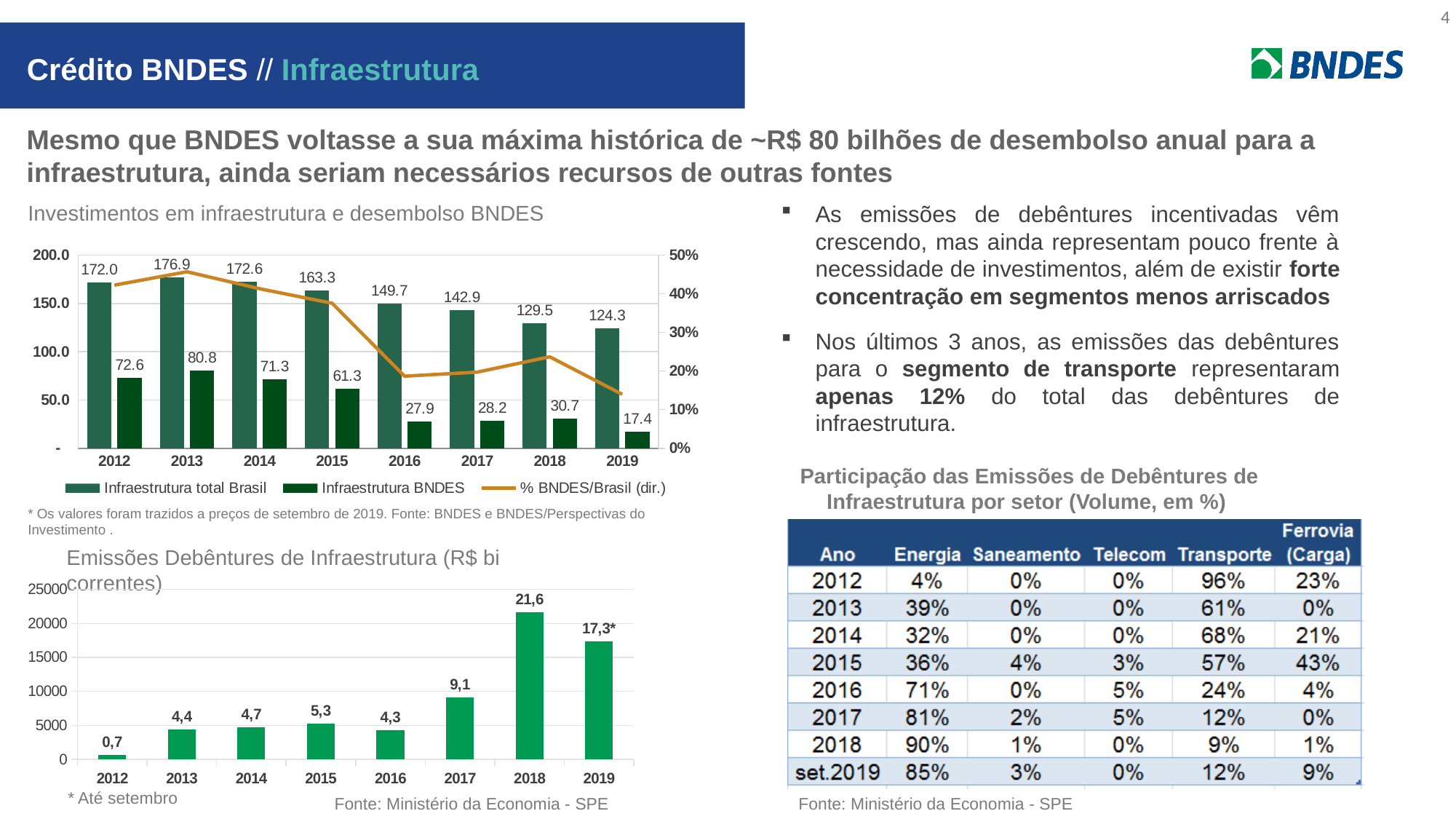
In the chart 'Investimentos em infraestrutura e desembolso BNDES', is the % BNDES/Brasil value for 2013 greater or less than 40%? greater In the chart 'Emissões Debêntures de Infraestrutura (R$ bi correntes)', how many years are shown on the x axis? 8 In the chart 'Emissões Debêntures de Infraestrutura (R$ bi correntes)', what is the value for 2017? 9,1 In the chart 'Emissões Debêntures de Infraestrutura (R$ bi correntes)', which year has the lowest value? 2012 In the chart 'Investimentos em infraestrutura e desembolso BNDES', does Infraestrutura total Brasil rise or fall from 2013 to 2019? fall In the chart 'Investimentos em infraestrutura e desembolso BNDES', which year has the highest value for Infraestrutura BNDES? 2013 In the chart 'Investimentos em infraestrutura e desembolso BNDES', how many series does the legend list? 3 In the chart 'Investimentos em infraestrutura e desembolso BNDES', what is the value of Infraestrutura BNDES for 2019? 17.4 What kind of chart is 'Emissões Debêntures de Infraestrutura (R$ bi correntes)'? bar chart In the chart 'Investimentos em infraestrutura e desembolso BNDES', what is the difference between Infraestrutura total Brasil and Infraestrutura BNDES in 2012? 99.4 In the chart 'Investimentos em infraestrutura e desembolso BNDES', what is the value of Infraestrutura total Brasil for 2015? 163.3 In the chart 'Emissões Debêntures de Infraestrutura (R$ bi correntes)', which year has the highest value? 2018